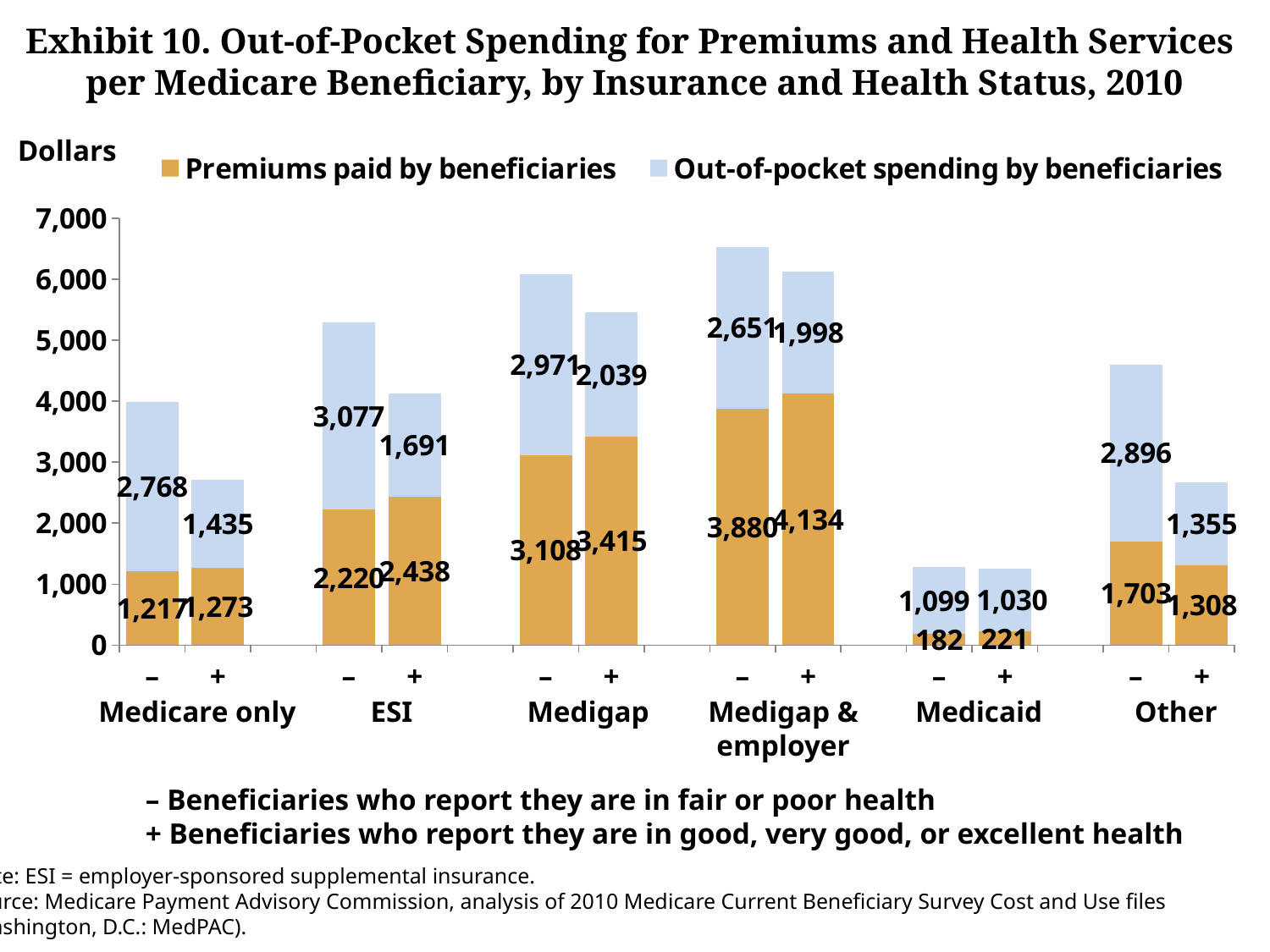
Is the total of the stacked bar for Medigap & employer – greater or less than 6,000? greater Which bar has the highest out-of-pocket spending by beneficiaries? ESI – What is the total of the stacked bar for Medicare only beneficiaries in fair or poor health (–)? 3,985 Which is larger: out-of-pocket spending by beneficiaries for Other – or for Medicare only –? Other – How many series does the legend list? 2 What is the out-of-pocket spending by beneficiaries for ESI beneficiaries in fair or poor health (–)? 3,077 How many bars are plotted in the chart? 12 What is the value of premiums paid by beneficiaries for Medigap & employer beneficiaries in good, very good, or excellent health (+)? 4,134 Which bar has the lowest premiums paid by beneficiaries? Medicaid – What type of chart is shown on the slide? Stacked bar chart What is the value of premiums paid by beneficiaries for Medicaid beneficiaries in fair or poor health (–)? 182 What is the difference between premiums paid by beneficiaries for Medigap + and Medigap –? 307